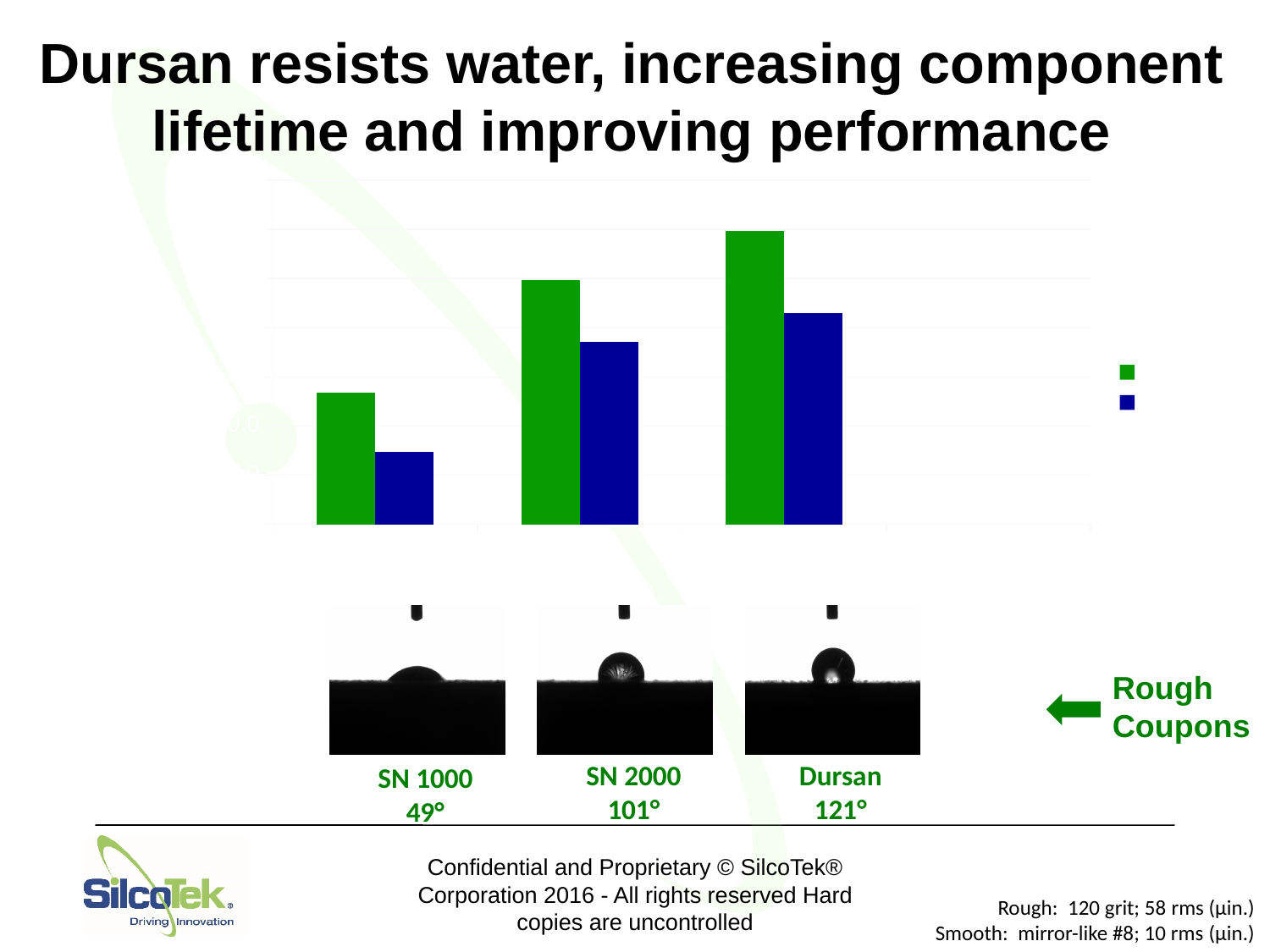
How many series does the chart's legend list? 2 Is the green bar in the middle group taller or shorter than the blue bar in the rightmost group? taller Which group of bars has the shortest green bar? the leftmost group (SN 1000) What kind of chart is shown on the slide? bar chart In the rightmost group of bars, is the green bar or the blue bar taller? green How many groups of bars does the chart show? 3 In the leftmost group of bars, is the green bar or the blue bar taller? green Which group of bars has the tallest green bar? the rightmost group (Dursan) What two colours are used for the bar series in the chart? green and blue Do the blue bars rise or fall from left to right across the chart? rise Do the green bars rise or fall from left to right across the chart? rise